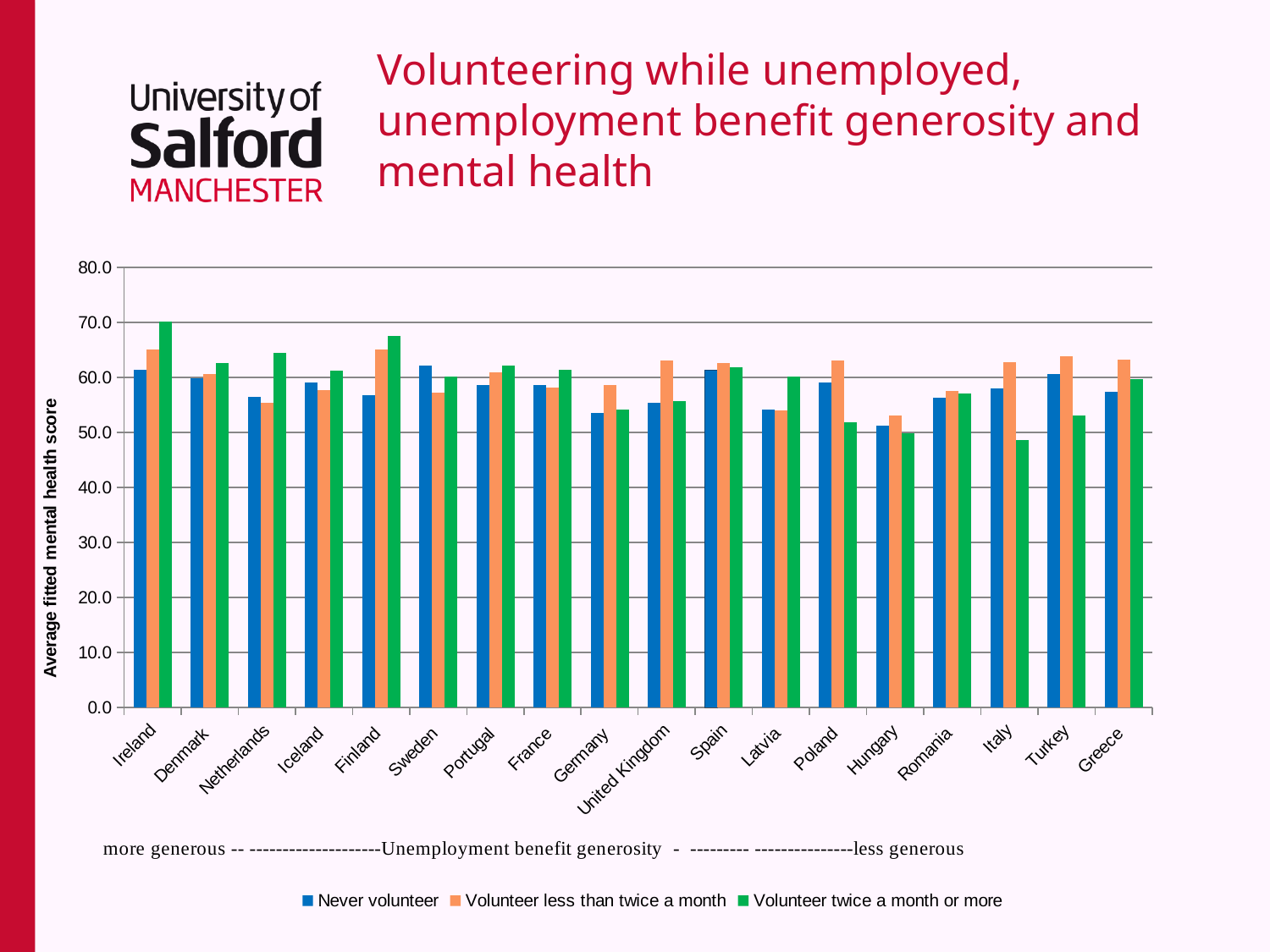
Is the value for 'Volunteer twice a month or more' in Italy greater or less than 60? less What kind of chart is shown on the slide? bar chart Which country has the highest value for 'Volunteer twice a month or more'? Ireland Is the value for 'Volunteer less than twice a month' in Ireland greater or less than 60? greater In Ireland, which is larger: 'Never volunteer' or 'Volunteer twice a month or more'? Volunteer twice a month or more What is the label of the vertical axis? Average fitted mental health score How many countries are shown on the x axis of the chart? 18 How many series does the chart's legend list? 3 Is the value for 'Never volunteer' in Germany greater or less than 60? less Which series is shown in green in the chart? Volunteer twice a month or more In Italy, which is larger: 'Never volunteer' or 'Volunteer twice a month or more'? Never volunteer